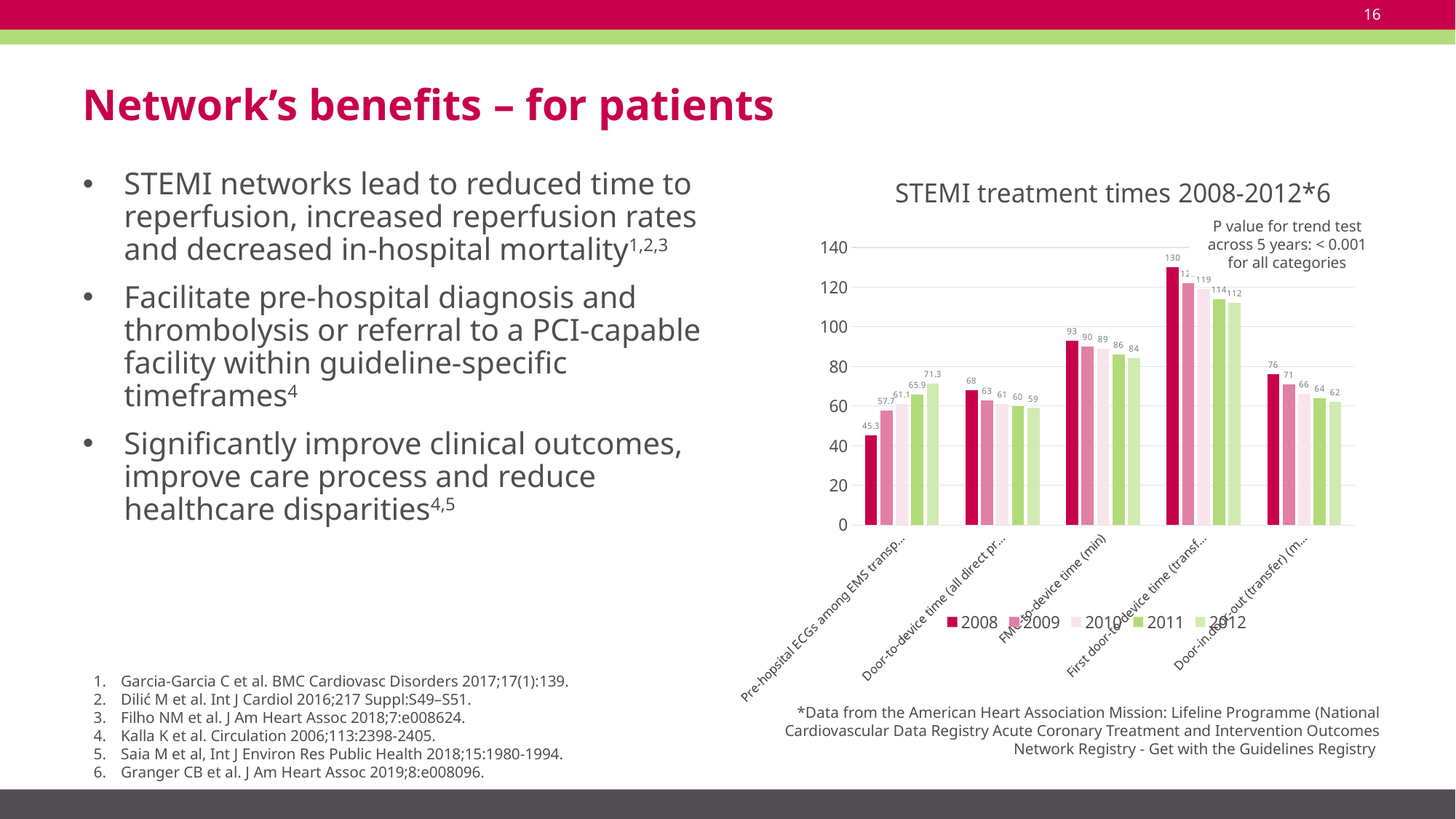
How many categories are shown on the x axis of the STEMI treatment times chart? 5 Which is larger in 2008: the Door-to-device time (all direct) value or the Door-in-door-out (transfer) value? Door-in-door-out (transfer) What is the 2008 value for the Door-in-door-out (transfer) category? 76 Do the values for the Pre-hospital ECGs among EMS transport category rise or fall from 2008 to 2012? rise What is the 2012 value for the Pre-hospital ECGs among EMS transport category? 71.3 What is the difference between the 2008 and 2012 values for FMC-to-device time (min)? 9 What kind of chart is shown on the slide? bar chart How many series does the legend of the STEMI treatment times chart list? 5 Which year has the highest value for the First door-to-device time (transfer) category? 2008 What is the 2012 value for FMC-to-device time (min)? 84 Do the values for the Door-in-door-out (transfer) category rise or fall from 2008 to 2012? fall What is the 2008 value for FMC-to-device time (min)? 93